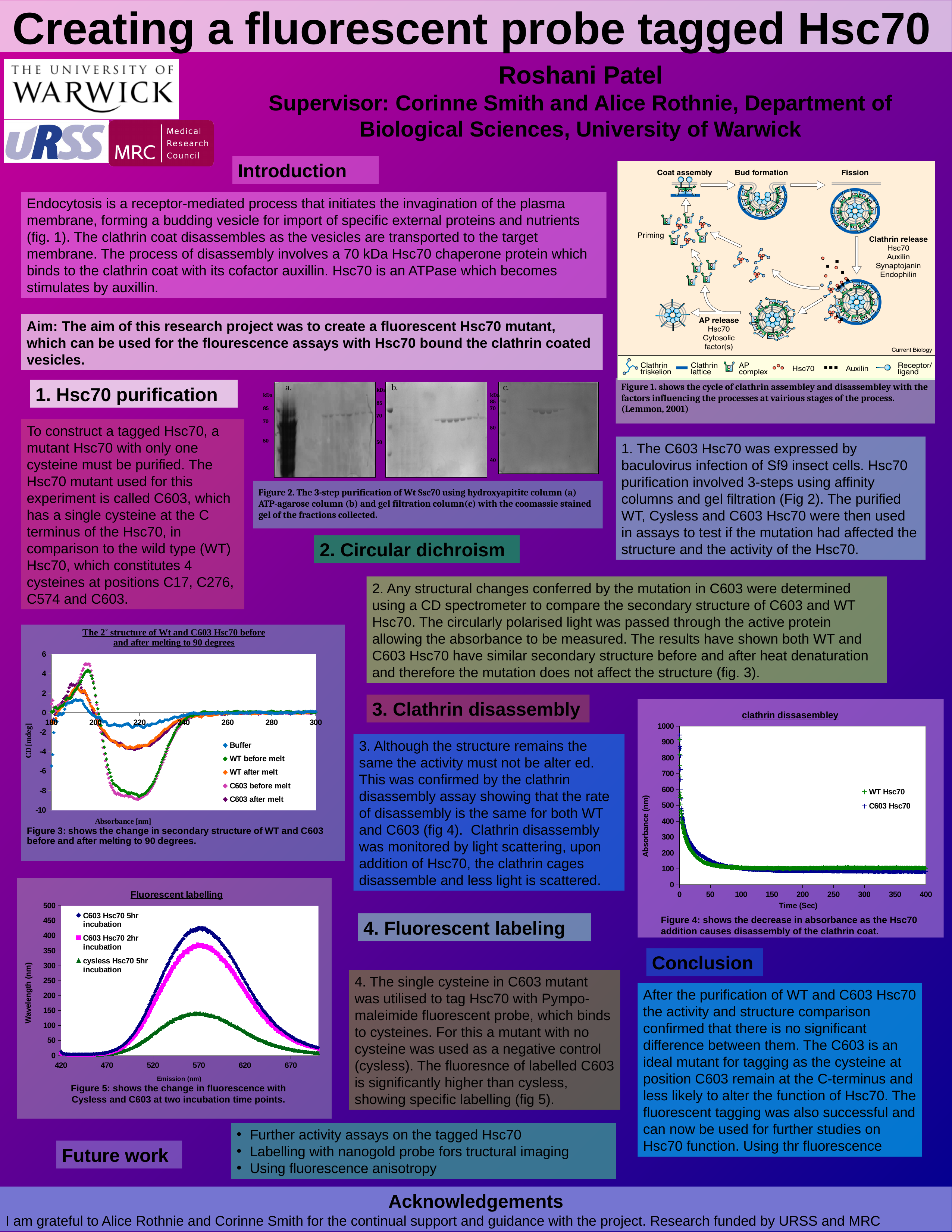
On the chart titled 'The 2° structure of Wt and C603 Hsc70 before and after melting to 90 degrees', what is the label of the y axis? CD [mdeg] On the 'clathrin dissasembley' chart, is the absorbance for WT Hsc70 at 400 seconds greater or less than 200? less On the 'Fluorescent labelling' chart, which series peaks higher: C603 Hsc70 2hr incubation or cysless Hsc70 5hr incubation? C603 Hsc70 2hr incubation On the 'Fluorescent labelling' chart, how many series does the legend list? 3 On the 'clathrin dissasembley' chart, what is the label of the x axis? Time (Sec) On the chart titled 'The 2° structure of Wt and C603 Hsc70 before and after melting to 90 degrees', how many series does the legend list? 5 On the 'clathrin dissasembley' chart, how many series does the legend list? 2 On the 'Fluorescent labelling' chart, is the peak value for cysless Hsc70 5hr incubation greater or less than 200? less On the 'Fluorescent labelling' chart, which series has the lowest peak? cysless Hsc70 5hr incubation On the 'Fluorescent labelling' chart, is the peak value for C603 Hsc70 5hr incubation greater or less than 400? greater On the 'clathrin dissasembley' chart, do the absorbance values rise or fall as time increases? fall On the 'Fluorescent labelling' chart, which series reaches the highest peak? C603 Hsc70 5hr incubation